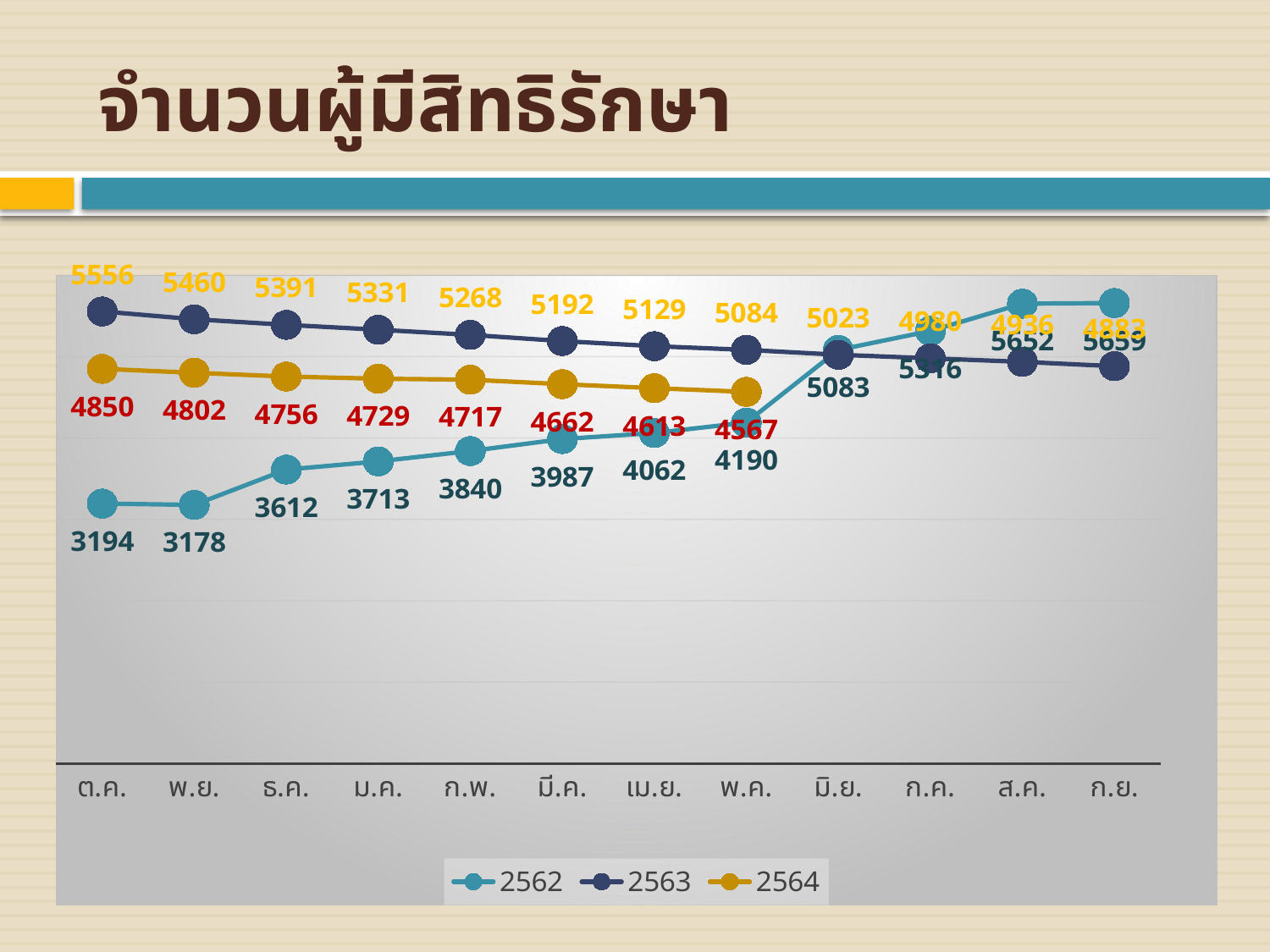
Do the values for series 2563 rise or fall from ต.ค. to ก.ย.? fall In which month does series 2562 reach its highest value? ก.ย. How many series does the legend list? 3 What is the difference between the 2563 value and the 2564 value in ต.ค.? 706 Which is larger in ม.ค., the value for 2563 or the value for 2564? 2563 What is the value for series 2564 in พ.ค.? 4567 How many data points are plotted for series 2564? 8 In which month does series 2562 have its lowest value? พ.ย. What is the value for series 2562 in ต.ค.? 3194 How many months are shown on the x axis? 12 What is the value for series 2563 in ก.ย.? 4883 What type of chart is shown on the slide? line chart